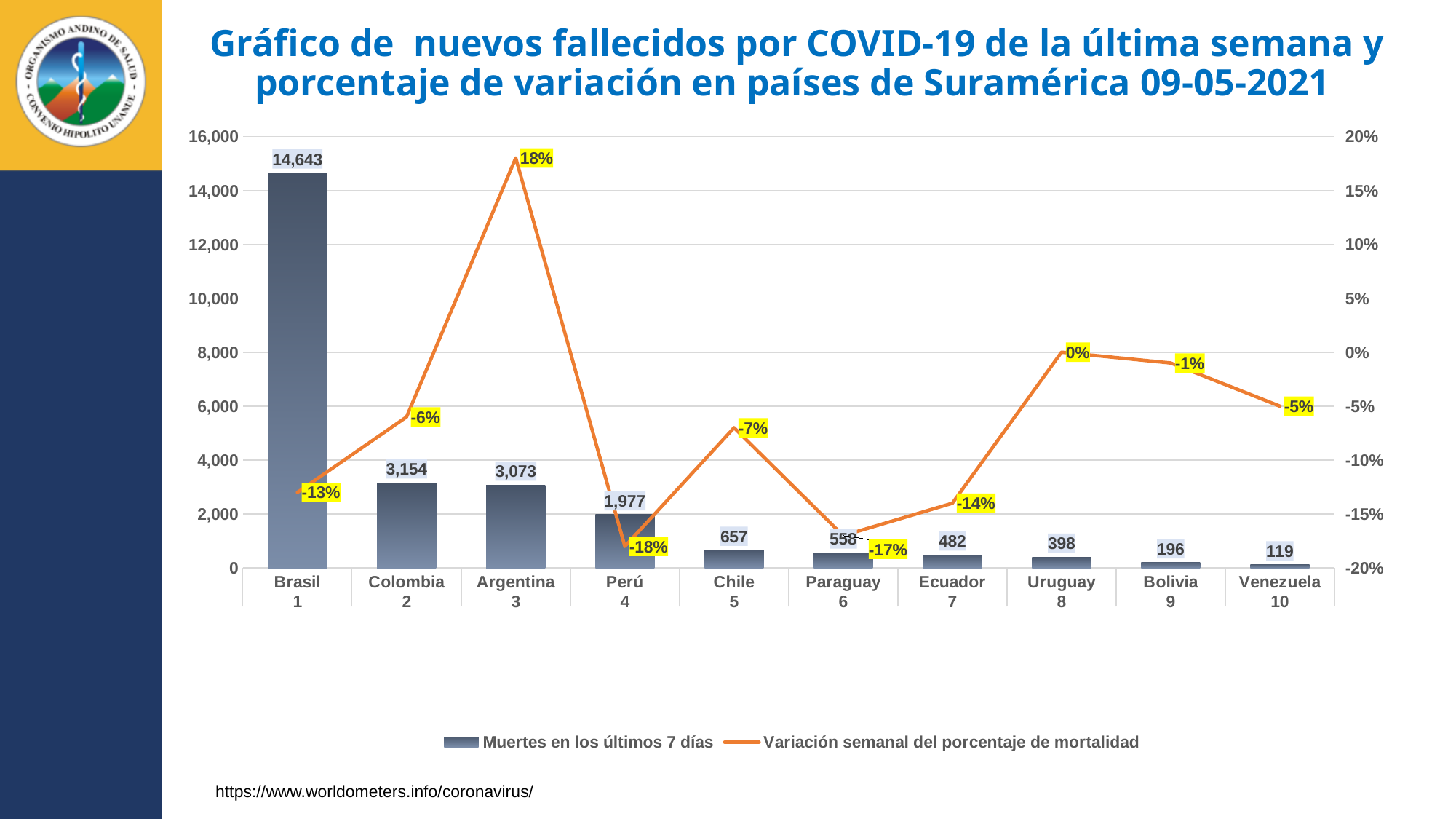
Which country has the lowest weekly variation percentage? Perú Which country has the lowest number of deaths in the last 7 days? Venezuela How many deaths in the last 7 days are shown for Brasil? 14,643 What is the weekly variation percentage shown for Argentina? 18% What is the weekly variation percentage shown for Uruguay? 0% Which has more deaths in the last 7 days, Chile or Ecuador? Chile How many countries are shown on the chart? 10 How many deaths in the last 7 days are shown for Perú? 1,977 Which country has the highest number of deaths in the last 7 days? Brasil What colour is the line for 'Variación semanal del porcentaje de mortalidad'? Orange What is the difference in deaths in the last 7 days between Colombia and Argentina? 81 How many series does the legend list? 2